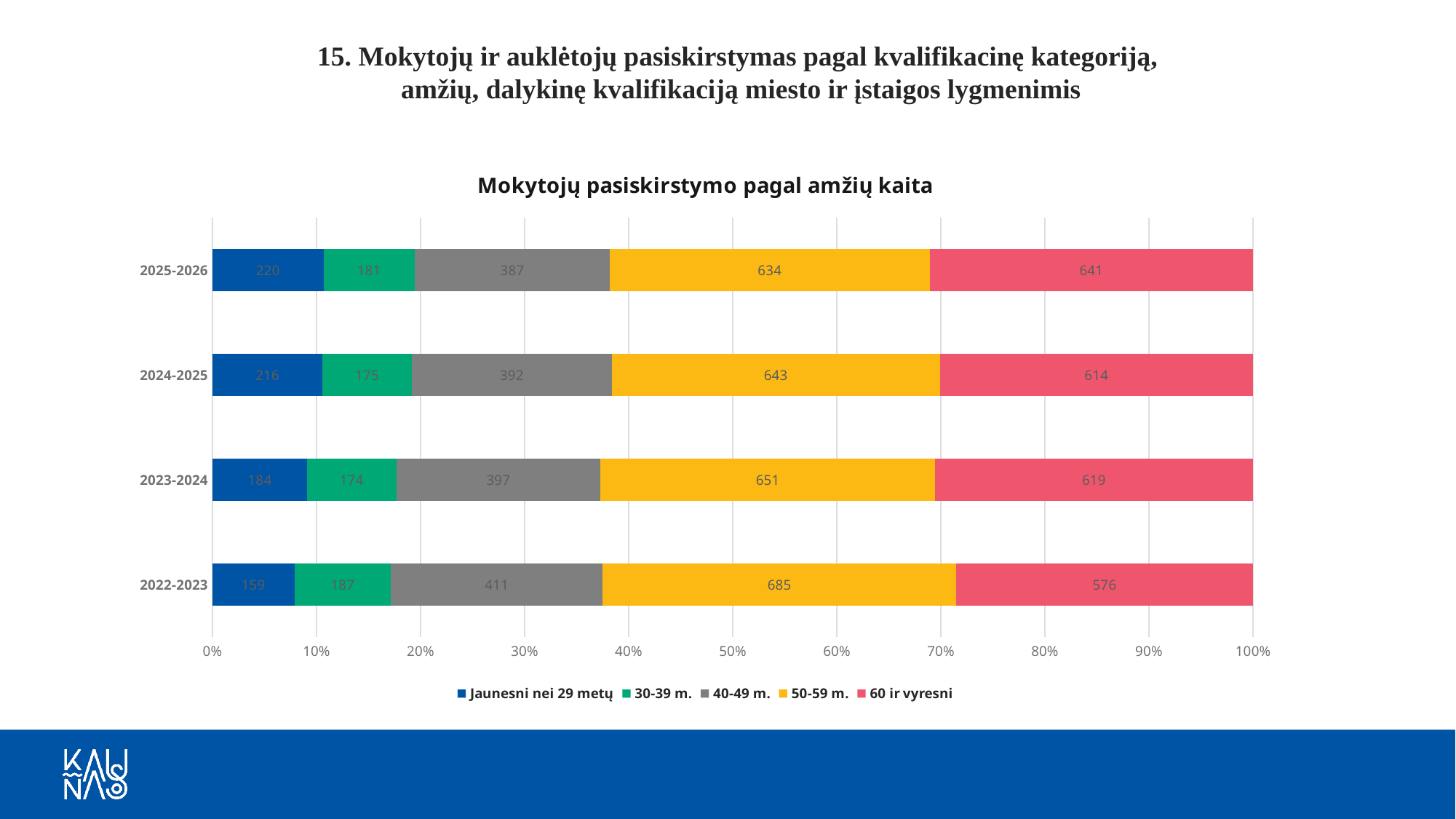
In which school year is the 'Jaunesni nei 29 metų' value lowest? 2022-2023 In which school year is the '40-49 m.' value highest? 2022-2023 What is the difference between the '50-59 m.' values in 2022-2023 and 2025-2026? 51 How many school years are shown on the chart? 4 What kind of chart is this? Stacked bar chart What is the value for 'Jaunesni nei 29 metų' in 2025-2026? 220 What is the total of the stacked bar for 2025-2026? 2063 Which is larger in 2023-2024: the '50-59 m.' value or the '60 ir vyresni' value? 50-59 m. What is the title of the chart? Mokytojų pasiskirstymo pagal amžių kaita What is the value for '60 ir vyresni' in 2024-2025? 614 How many series does the legend list? 5 What is the value for '50-59 m.' in 2022-2023? 685